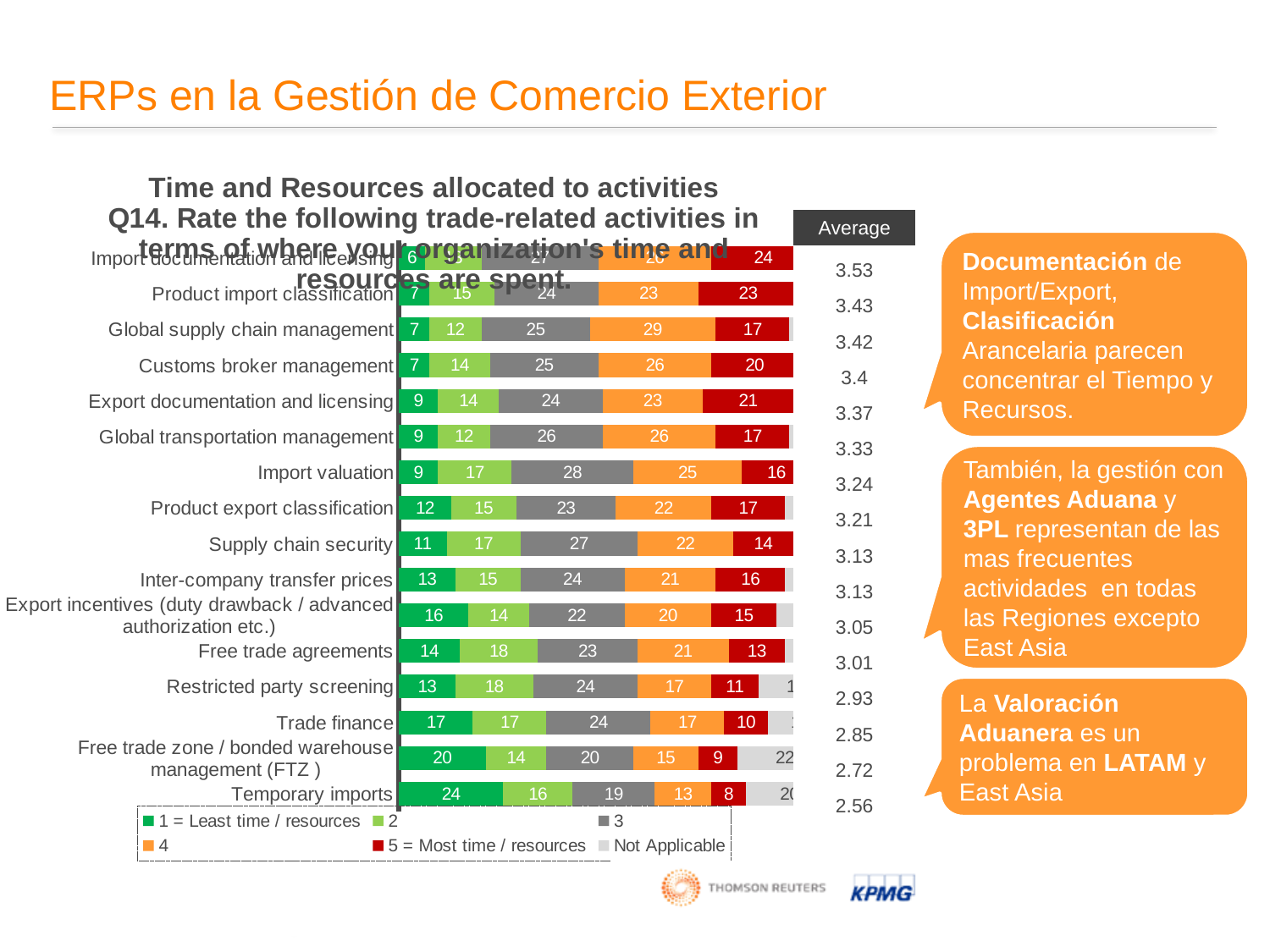
Which has the larger '1 = Least time / resources' value, Trade finance or Free trade agreements? Trade finance What is the 'Not Applicable' value for Free trade zone / bonded warehouse management (FTZ)? 22 How many series does the chart legend list? 6 What is the value of '1 = Least time / resources' for Temporary imports? 24 Which activity has the lowest value for '5 = Most time / resources'? Temporary imports How many trade-related activities (categories) are plotted in the chart? 16 Do the Average values increase or decrease going down the list of activities from top to bottom? decrease What is the Average shown for Customs broker management? 3.4 What kind of chart is shown on the slide? bar chart What is the value of series 2 for Restricted party screening? 18 What is the value of series 4 for Global supply chain management? 29